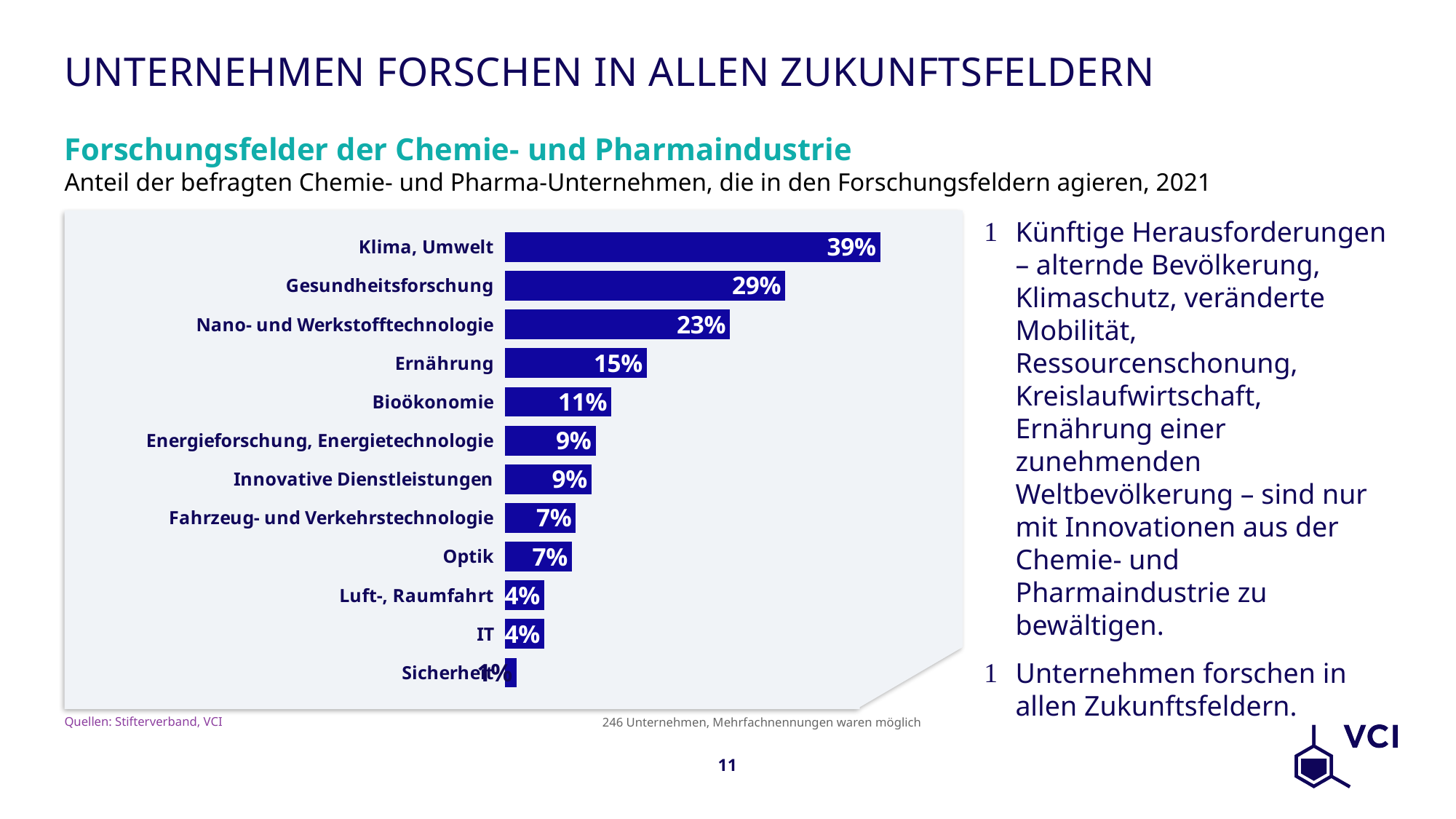
Which research field has the highest share? Klima, Umwelt What is the difference between the values for Klima, Umwelt and Gesundheitsforschung? 10% What kind of chart is shown on the slide? Bar chart Which is larger, the value for Ernährung or the value for Optik? Ernährung How many research fields are shown in the chart? 12 What is the value for Luft-, Raumfahrt? 4% What is the value for Klima, Umwelt? 39% Which research field has the lowest share? Sicherheit What is the value for Bioökonomie? 11% What is the value for Nano- und Werkstofftechnologie? 23% What is the value for Gesundheitsforschung? 29% What is the title of the chart? Forschungsfelder der Chemie- und Pharmaindustrie